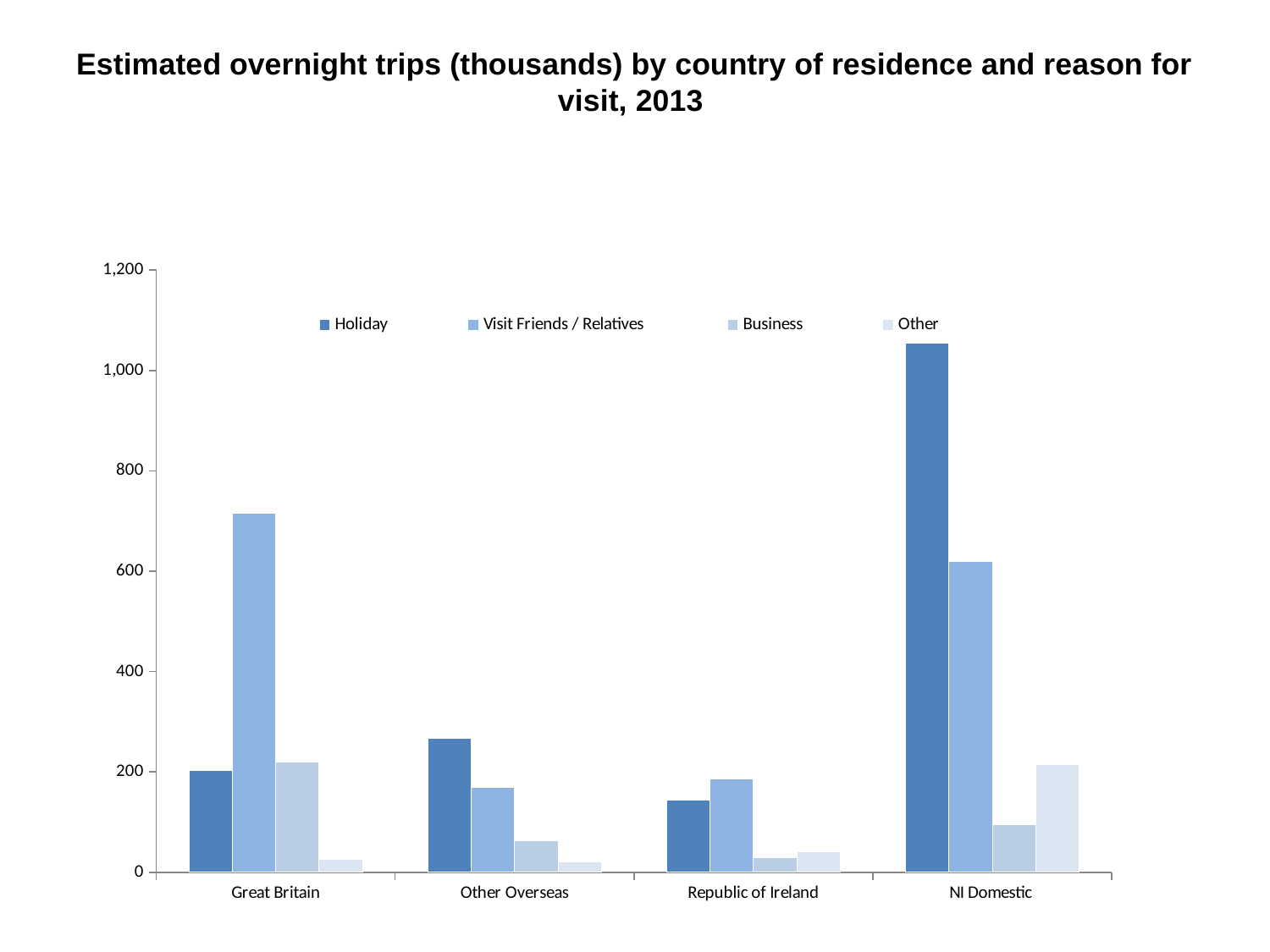
Is the Holiday value for NI Domestic greater or less than 1,000? greater Which country of residence has the highest value for Holiday? NI Domestic Is the Holiday value for Republic of Ireland greater or less than 200? less For Great Britain, which reason for visit has the highest value? Visit Friends / Relatives Is the Visit Friends / Relatives value for Great Britain greater or less than 600? greater How many countries of residence are shown on the x axis? 4 For Other Overseas, which reason for visit has the lowest value? Other Which is larger: the Holiday value for Other Overseas or for Republic of Ireland? Other Overseas What year does the chart title say the data refers to? 2013 How many series does the legend list? 4 Which is larger: the Visit Friends / Relatives value for Great Britain or for NI Domestic? Great Britain What kind of chart is shown on the slide? Bar chart